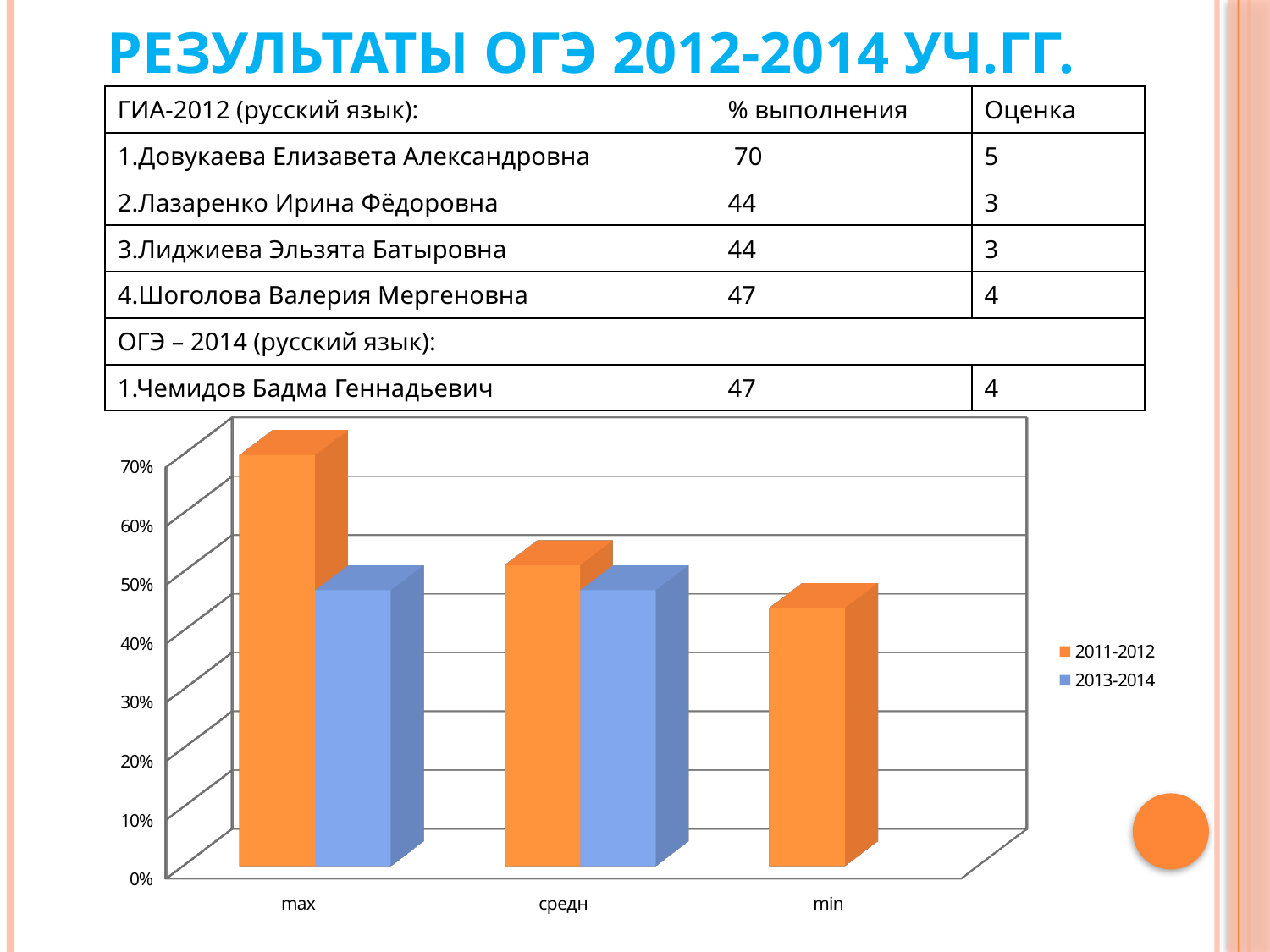
Which category has the lowest value for the 2011-2012 series? min Is the 2011-2012 value for max greater or less than 60%? greater Do the 2011-2012 values rise or fall from max to min along the x axis? fall Which category has the highest value for the 2011-2012 series? max Is the 2011-2012 value for средн greater or less than 40%? greater How many series does the chart legend list? 2 What kind of chart is shown on the slide? bar chart Which colour represents the 2011-2012 series in the chart? orange Is the 2011-2012 value for min greater or less than 50%? less How many categories are shown on the x axis of the chart? 3 For the max category, which series has the larger value, 2011-2012 or 2013-2014? 2011-2012